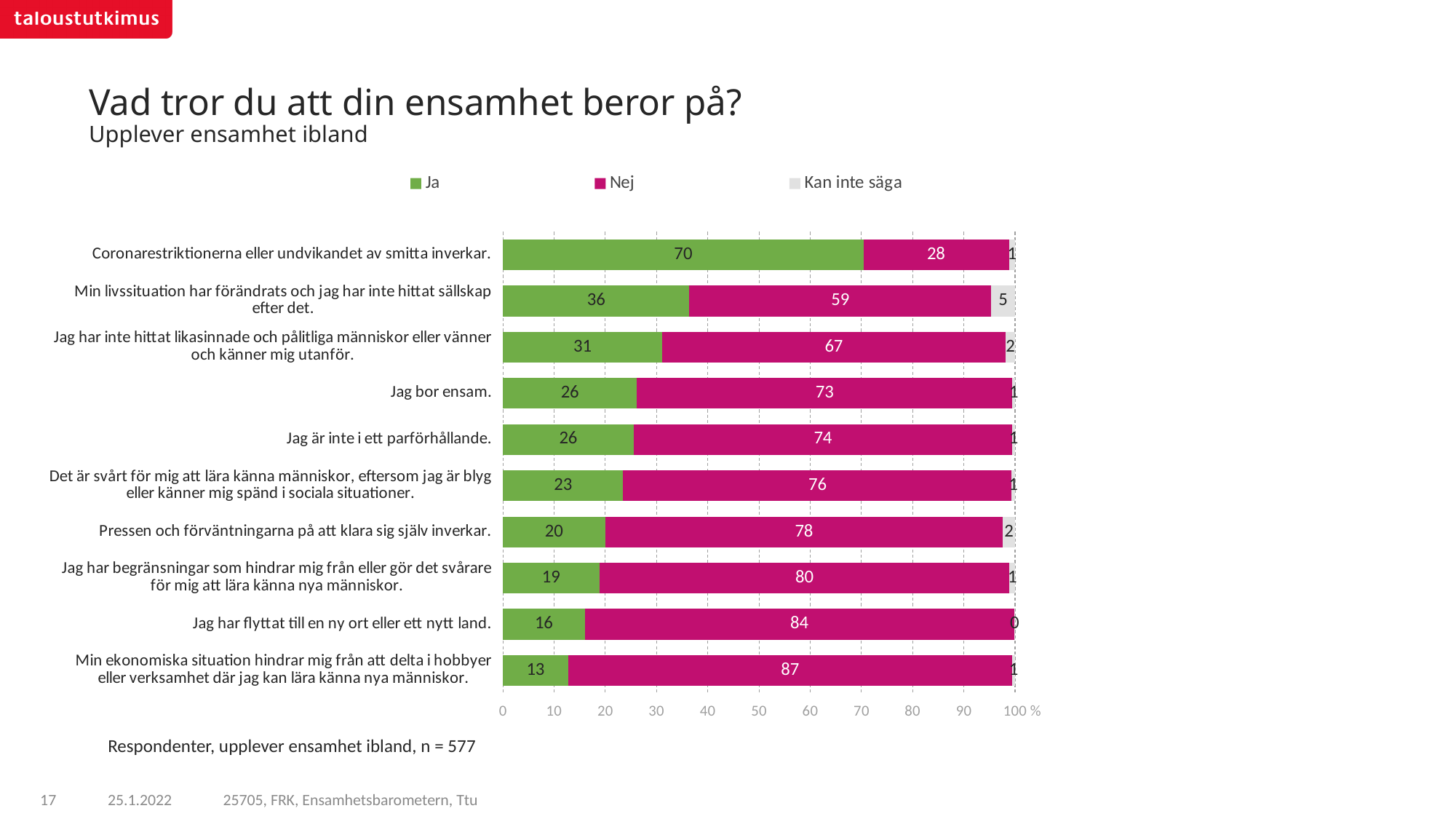
Which category has the highest "Ja" value? Coronarestriktionerna eller undvikandet av smitta inverkar. Which category has the lowest "Ja" value? Min ekonomiska situation hindrar mig från att delta i hobbyer eller verksamhet där jag kan lära känna nya människor. Which is larger: the "Ja" value for "Pressen och förväntningarna på att klara sig själv inverkar." or the "Ja" value for "Jag har begränsningar som hindrar mig från eller gör det svårare för mig att lära känna nya människor."? Pressen och förväntningarna på att klara sig själv inverkar. What kind of chart is shown on the slide? Stacked bar chart What is the difference between the "Nej" value for "Jag är inte i ett parförhållande." and the "Nej" value for "Jag bor ensam."? 1 What is the "Nej" value for "Jag har flyttat till en ny ort eller ett nytt land."? 84 What is the total of the stacked bar for "Jag har inte hittat likasinnade och pålitliga människor eller vänner och känner mig utanför."? 100 How many series does the legend list? 3 What is the "Kan inte säga" value for "Min livssituation har förändrats och jag har inte hittat sällskap efter det."? 5 What is the "Ja" value for "Jag bor ensam."? 26 What is the sample size stated below the chart? n = 577 How many categories are shown in the chart? 10